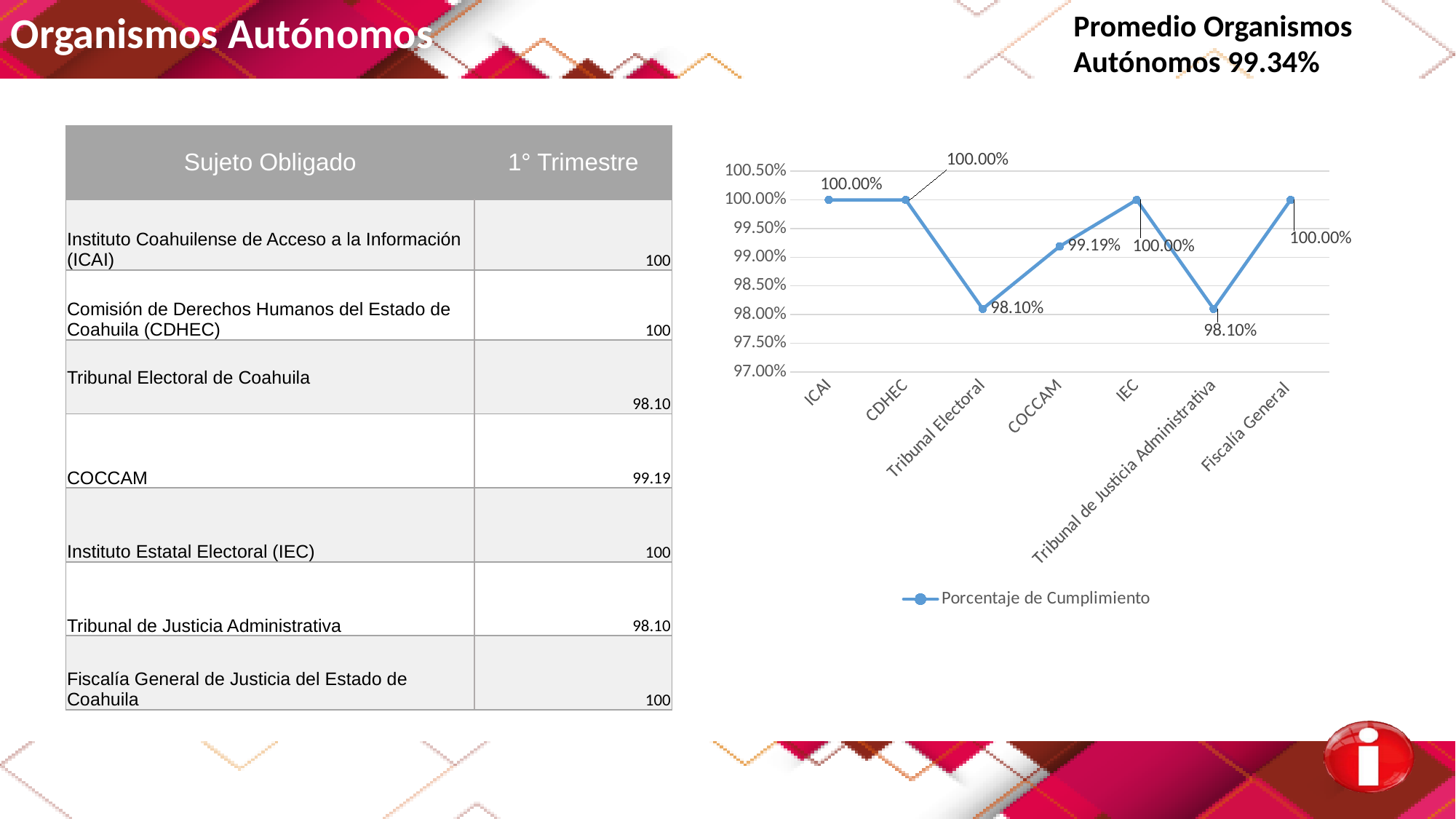
How many series does the chart legend list? 1 Which is larger, the value for COCCAM or the value for Tribunal de Justicia Administrativa? COCCAM How many categories are plotted on the x axis of the chart? 7 What is the difference between the value for IEC and the value for COCCAM? 0.81% What is the value for COCCAM in the chart? 99.19% What type of chart is shown on the slide? line chart What is the value for ICAI in the chart? 100.00% What is the value for Tribunal Electoral in the chart? 98.10% What is the name of the series shown in the chart legend? Porcentaje de Cumplimiento What is the difference between the value for COCCAM and the value for Tribunal Electoral? 1.09% Is the value for COCCAM greater or less than 99.00%? greater What is the value for Tribunal de Justicia Administrativa in the chart? 98.10%